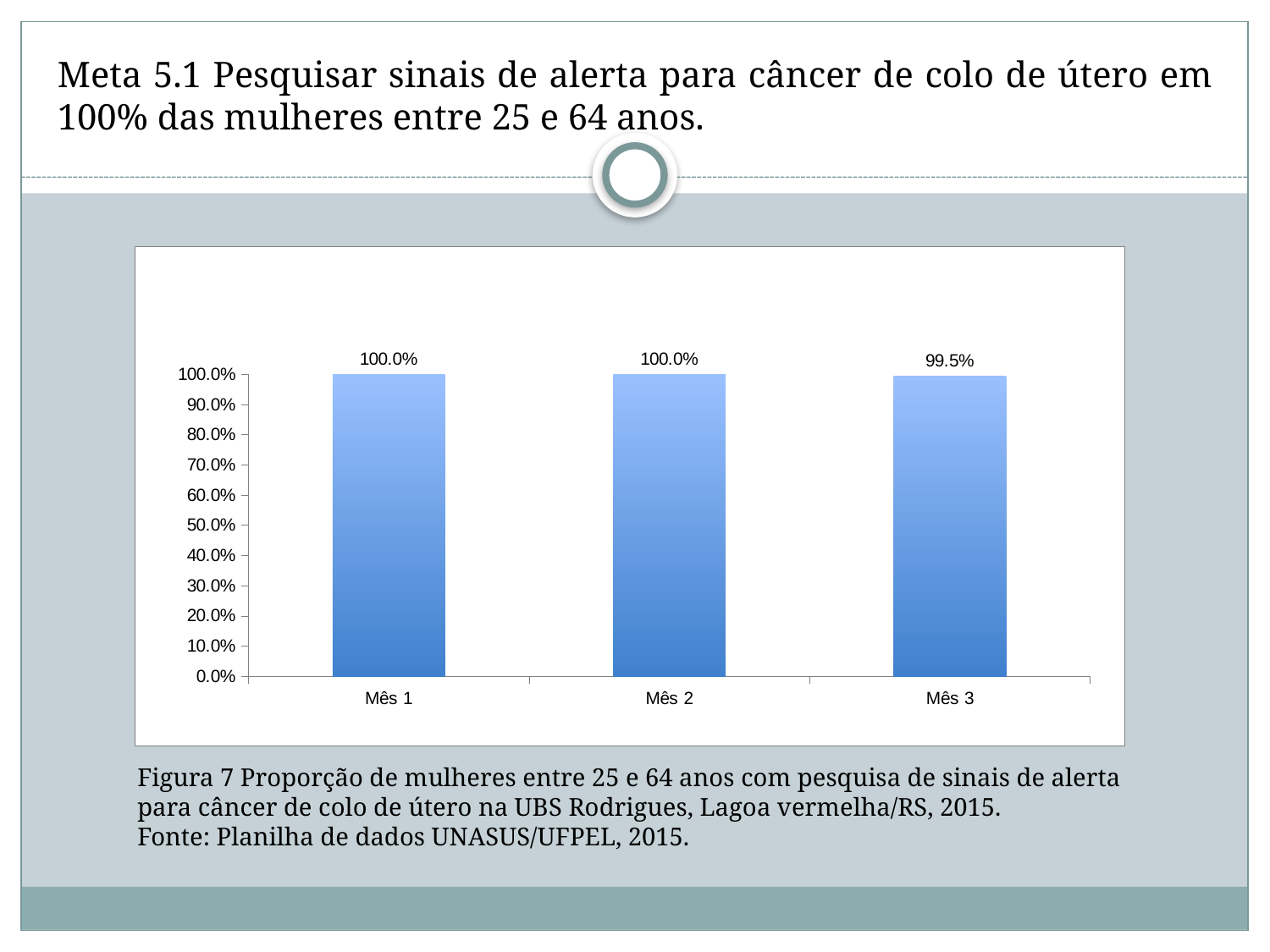
What is the value for Mês 2? 100.0% What is the highest tick value shown on the y axis? 100.0% What is the difference between the values for Mês 1 and Mês 3? 0.5% Which month has the lowest value? Mês 3 Do the values rise or fall from Mês 2 to Mês 3? fall Which is larger, the value for Mês 2 or the value for Mês 3? Mês 2 What kind of chart is shown on the slide? bar chart Is the value for Mês 3 greater or less than 90.0%? greater How many months are shown on the x axis? 3 What is the figure number given in the caption below the chart? Figura 7 What is the value for Mês 3? 99.5% What is the value for Mês 1? 100.0%